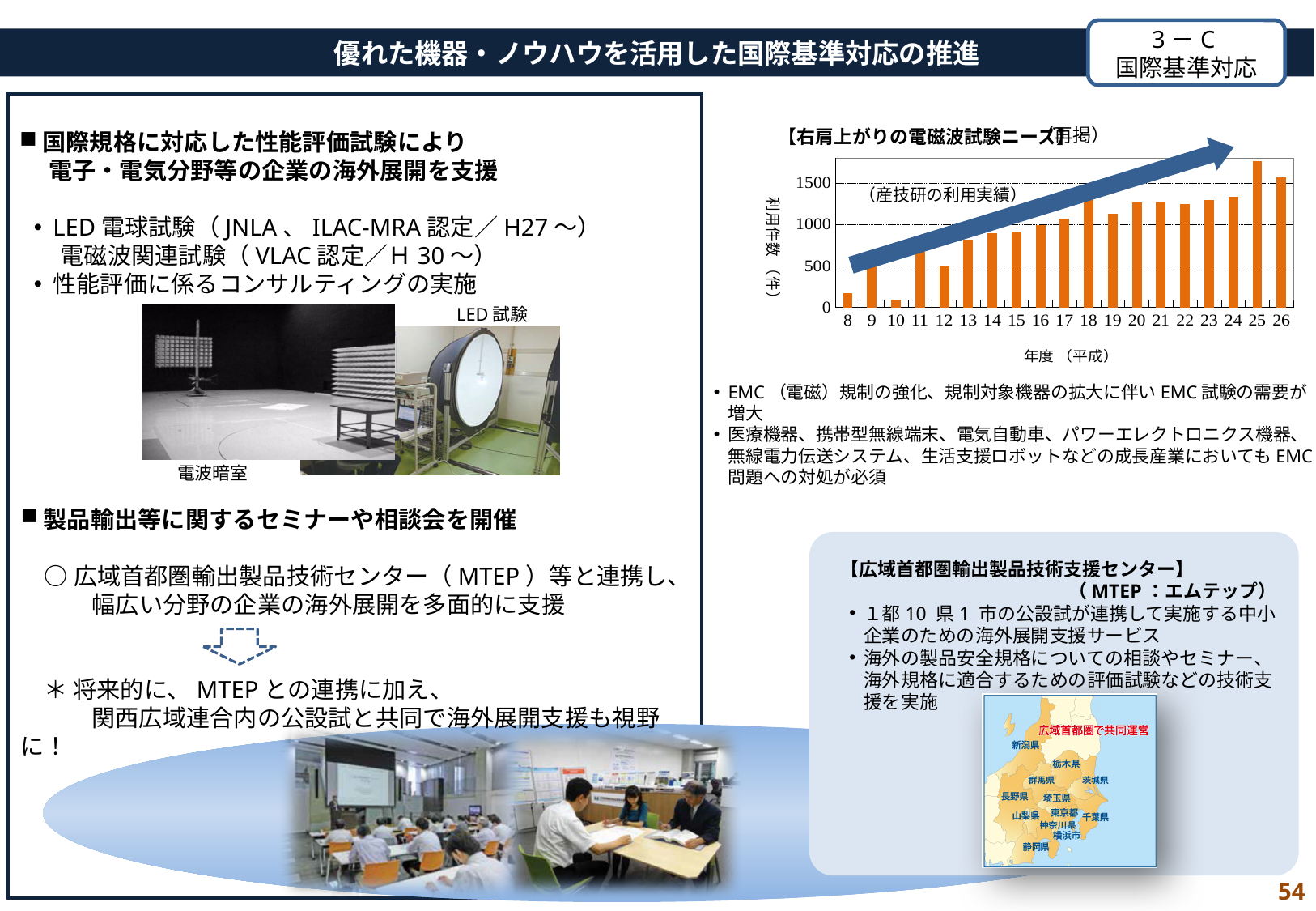
What kind of chart is shown on the slide? Bar chart Is the value for year 13 greater or less than 1000? less Which year (平成) has the highest 利用件数 in the chart? 25 Which year (平成) has the lowest 利用件数 in the chart? 10 Is the value for year 8 greater or less than 500? less Overall, do the values in the chart rise or fall from year 8 to year 26? Rise What is the label of the x axis of the chart? 年度（平成） Is the value for year 25 greater or less than 1500? greater Which year has the larger 利用件数, year 9 or year 11? 11 How many years (categories) are plotted on the x axis of the chart? 19 Which year has the larger 利用件数, year 26 or year 24? 26